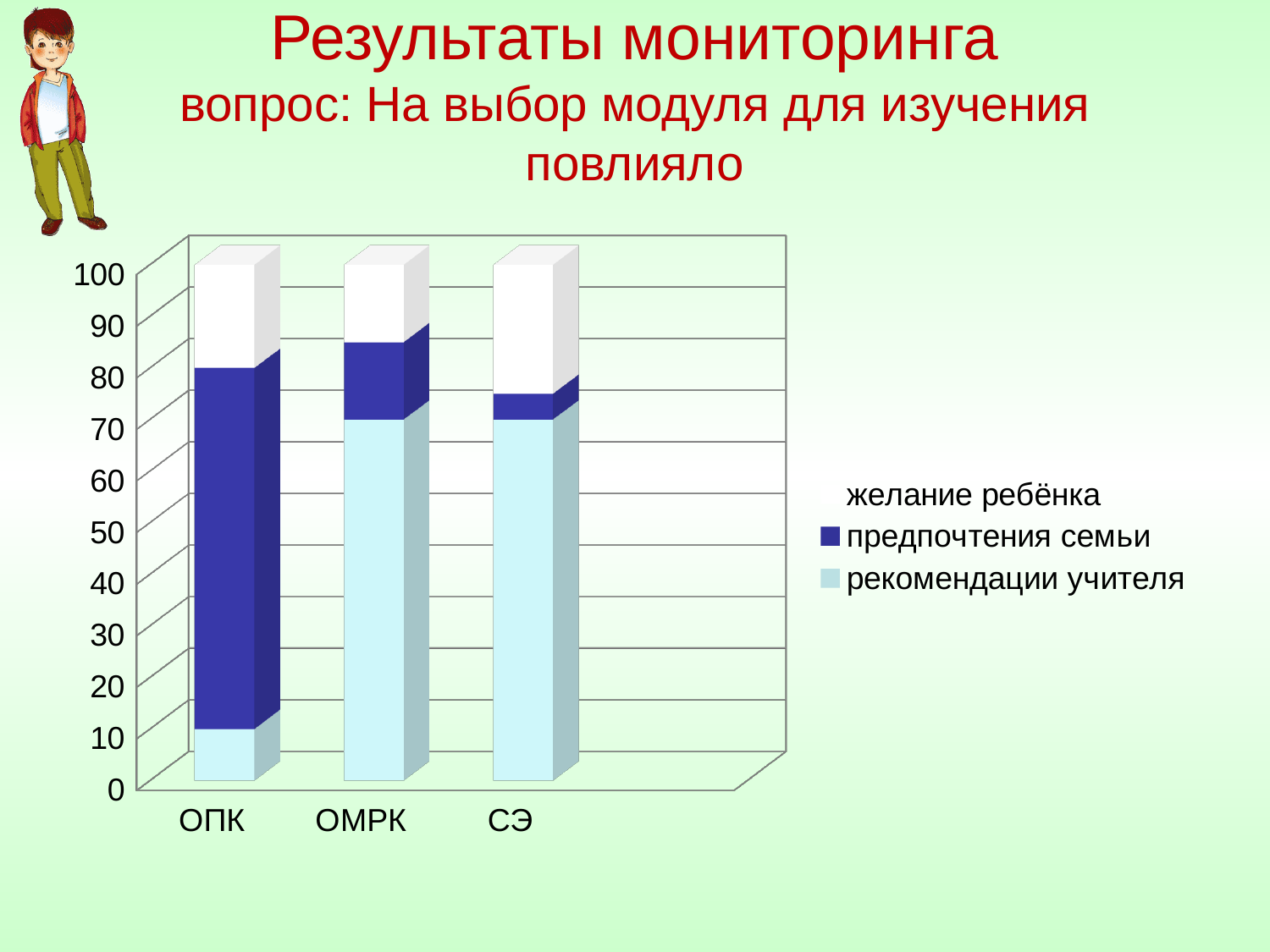
Which is larger, the рекомендации учителя value for ОМРК or for ОПК? ОМРК Which series is shown in light blue in the chart? рекомендации учителя What is the total height of the stacked bar for СЭ? 100 Which category has the largest предпочтения семьи segment? ОПК Which series is shown in dark blue in the chart? предпочтения семьи How many categories are shown on the x axis of the chart? 3 Is the value of рекомендации учителя for ОМРК greater or less than 50? greater What kind of chart is shown on the slide? stacked bar chart Is the value of предпочтения семьи for ОПК greater or less than 50? greater Which category has the smallest рекомендации учителя segment? ОПК How many series does the chart legend list? 3 Is the value of рекомендации учителя for ОПК greater or less than 20? less